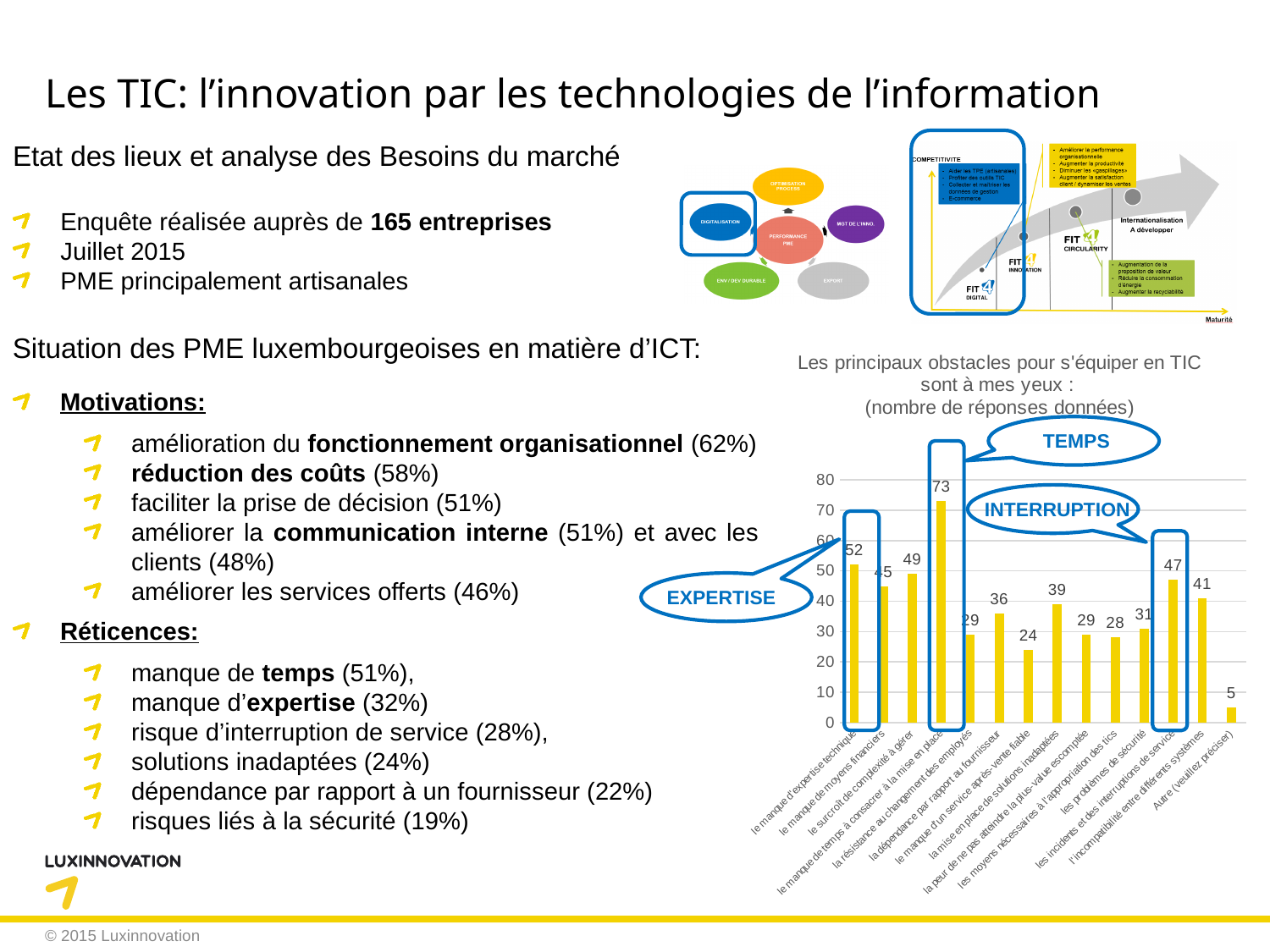
What is the highest value shown in the bar chart? 73 Which category has the highest value in the bar chart? le manque de temps à consacrer à la mise en place What is the value for 'les incidents et des interruptions de service' in the bar chart? 47 Which category has the lowest value in the bar chart? Autre (veuillez préciser) Which is larger in the bar chart: the value for 'le manque de moyens financiers' or 'le surcroît de complexité à gérer'? le surcroît de complexité à gérer What is the title of the bar chart? Les principaux obstacles pour s'équiper en TIC sont à mes yeux : (nombre de réponses données) What is the difference between the value for 'le manque de temps à consacrer à la mise en place' (73) and 'le manque d'expertise technique' (52)? 21 What type of chart is shown on the slide? bar chart What is the value for 'le manque d'expertise technique' in the bar chart? 52 What is the value for 'le manque d'un service après-vente fiable' in the bar chart? 24 Is the value for 'l'incompatibilité entre différents systèmes' greater or less than 30? greater How many bars (categories) does the bar chart contain? 14